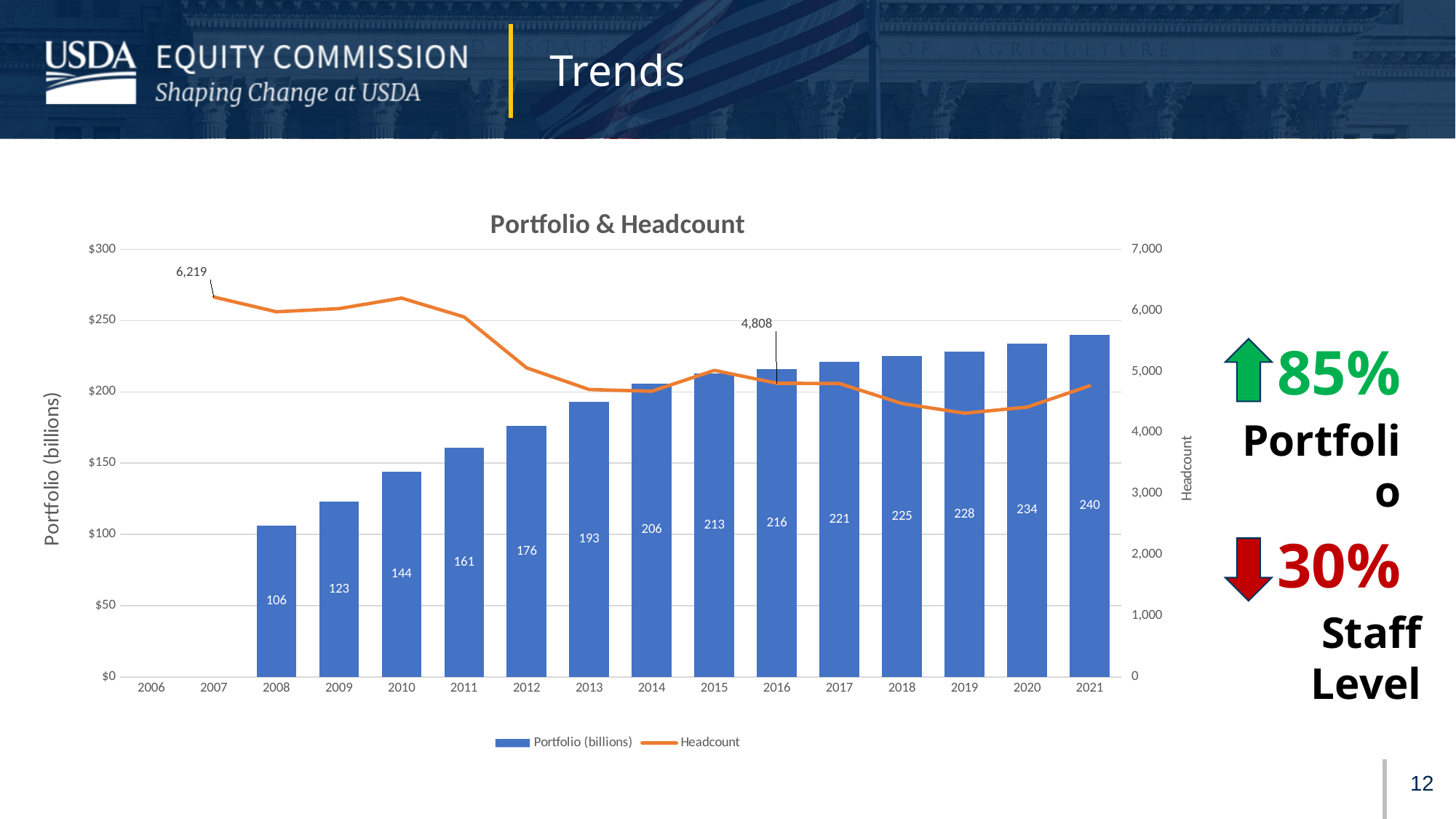
How many series does the legend list? 2 What is the difference between the Portfolio (billions) values for 2021 and 2008? 134 How many Portfolio (billions) bars are plotted? 14 What is the Portfolio (billions) value for 2021? 240 What is the Headcount value labelled for 2007? 6,219 Do the Portfolio (billions) values rise or fall from 2008 to 2021? rise Is the Headcount value for 2019 greater or less than 5,000? less Which year has the highest Portfolio (billions) bar? 2021 Which year has a larger Portfolio (billions) value, 2014 or 2015? 2015 What is the Headcount value labelled for 2016? 4,808 Which year has the lowest Portfolio (billions) bar? 2008 What is the Portfolio (billions) value for 2008? 106